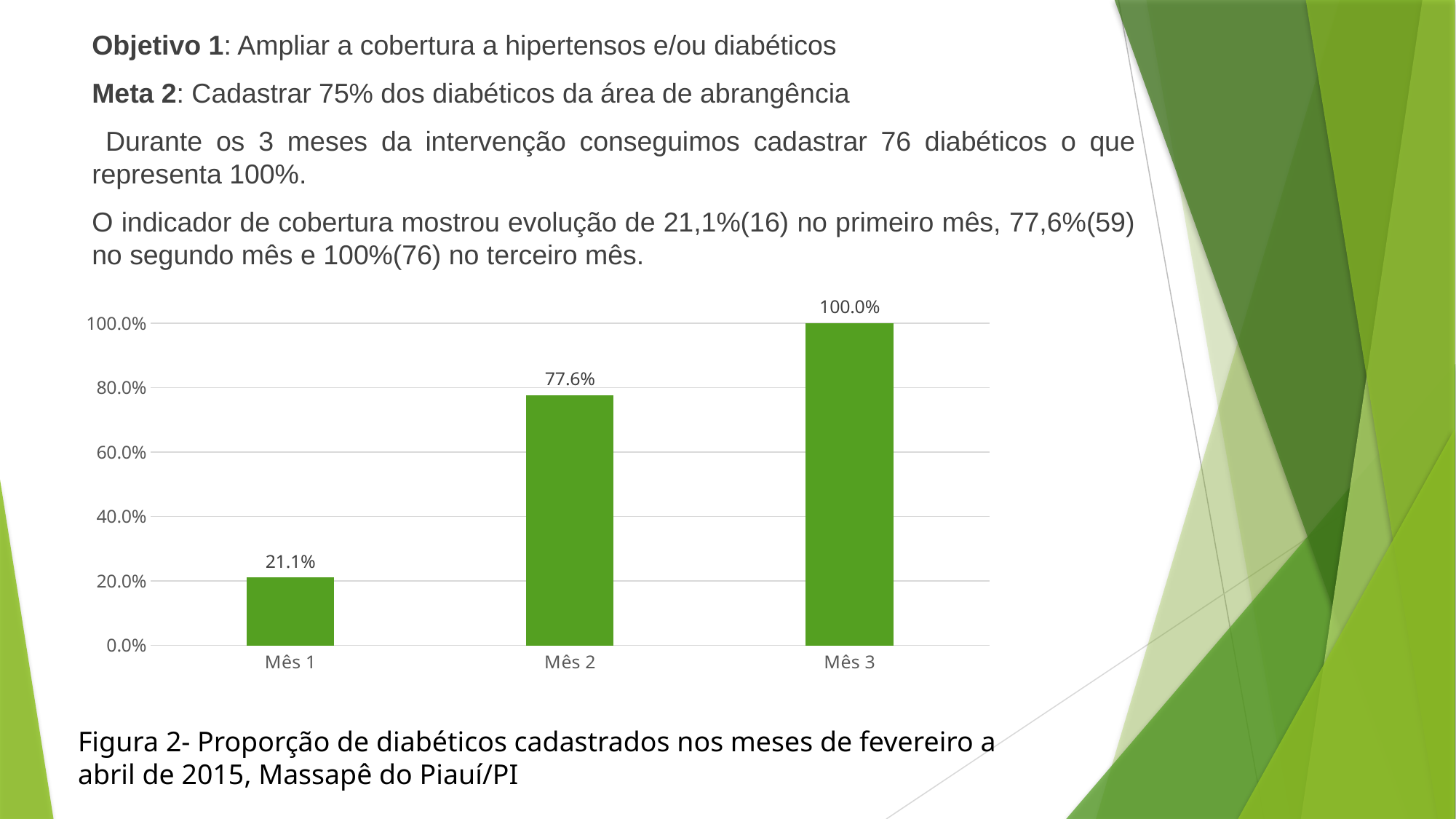
What is the value for Mês 1? 21.1% What kind of chart is shown on the slide? bar chart Do the values rise or fall from Mês 1 to Mês 3? rise What is the difference between the values for Mês 3 and Mês 2? 22.4% Which is larger, the value for Mês 1 or the value for Mês 2? Mês 2 What is the value for Mês 2? 77.6% Which month has the highest value? Mês 3 What is the value for Mês 3? 100.0% Which month has the lowest value? Mês 1 How many months are shown on the x axis? 3 What is the difference between the values for Mês 2 and Mês 1? 56.5% Is the value for Mês 2 greater or less than 60.0%? greater